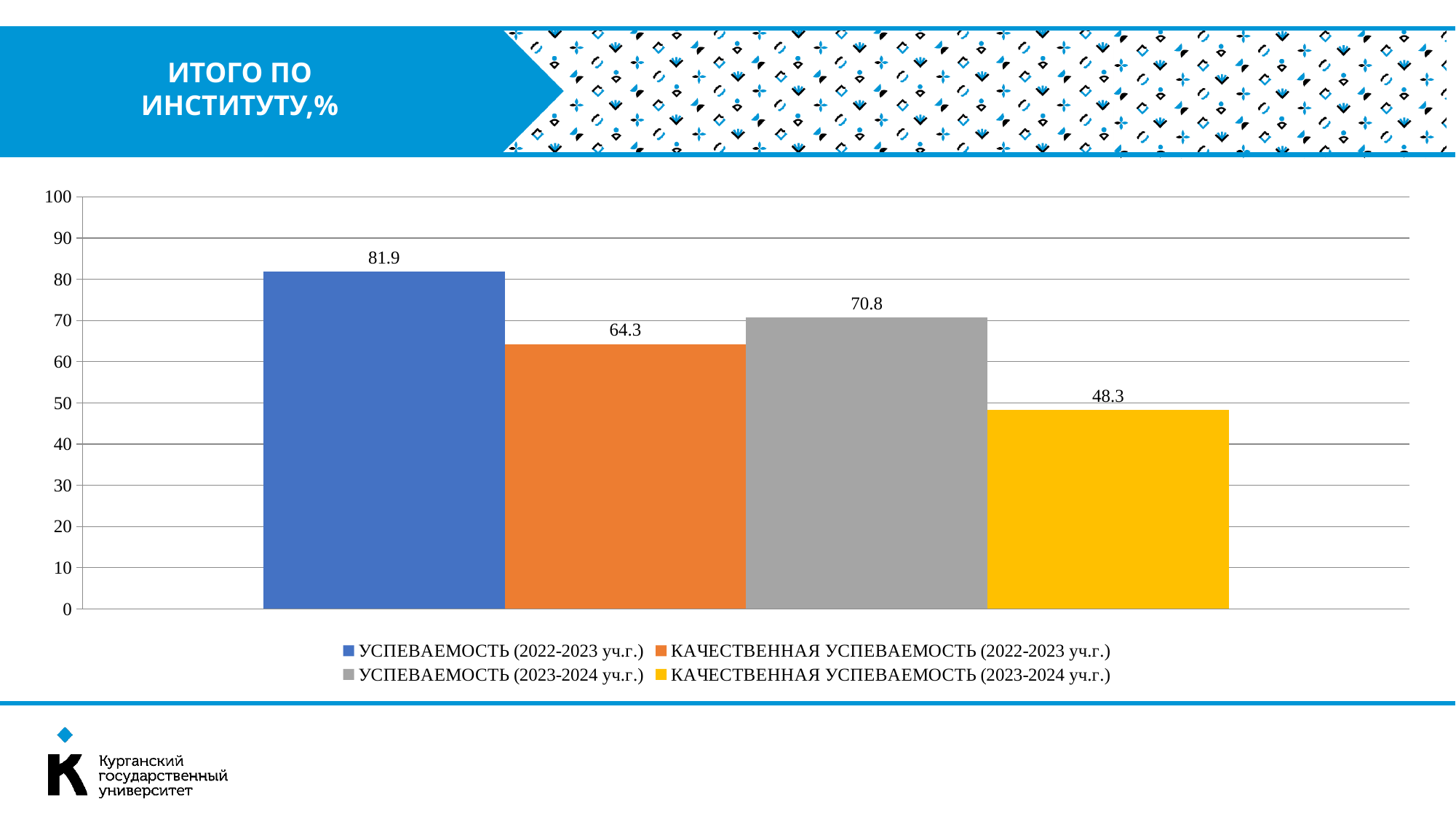
Which series has the lowest value? КАЧЕСТВЕННАЯ УСПЕВАЕМОСТЬ (2023-2024 уч.г.) Which series has the highest value? УСПЕВАЕМОСТЬ (2022-2023 уч.г.) What is the difference between КАЧЕСТВЕННАЯ УСПЕВАЕМОСТЬ (2022-2023 уч.г.) and КАЧЕСТВЕННАЯ УСПЕВАЕМОСТЬ (2023-2024 уч.г.)? 16 What is the value for УСПЕВАЕМОСТЬ (2022-2023 уч.г.)? 81.9 What is the title of the slide? ИТОГО ПО ИНСТИТУТУ,% Which is larger: КАЧЕСТВЕННАЯ УСПЕВАЕМОСТЬ (2022-2023 уч.г.) or УСПЕВАЕМОСТЬ (2023-2024 уч.г.)? УСПЕВАЕМОСТЬ (2023-2024 уч.г.) What is the value for УСПЕВАЕМОСТЬ (2023-2024 уч.г.)? 70.8 What is the difference between УСПЕВАЕМОСТЬ (2022-2023 уч.г.) and УСПЕВАЕМОСТЬ (2023-2024 уч.г.)? 11.1 What is the value for КАЧЕСТВЕННАЯ УСПЕВАЕМОСТЬ (2022-2023 уч.г.)? 64.3 What kind of chart is shown on the slide? Bar chart What is the value for КАЧЕСТВЕННАЯ УСПЕВАЕМОСТЬ (2023-2024 уч.г.)? 48.3 How many series does the legend list? 4